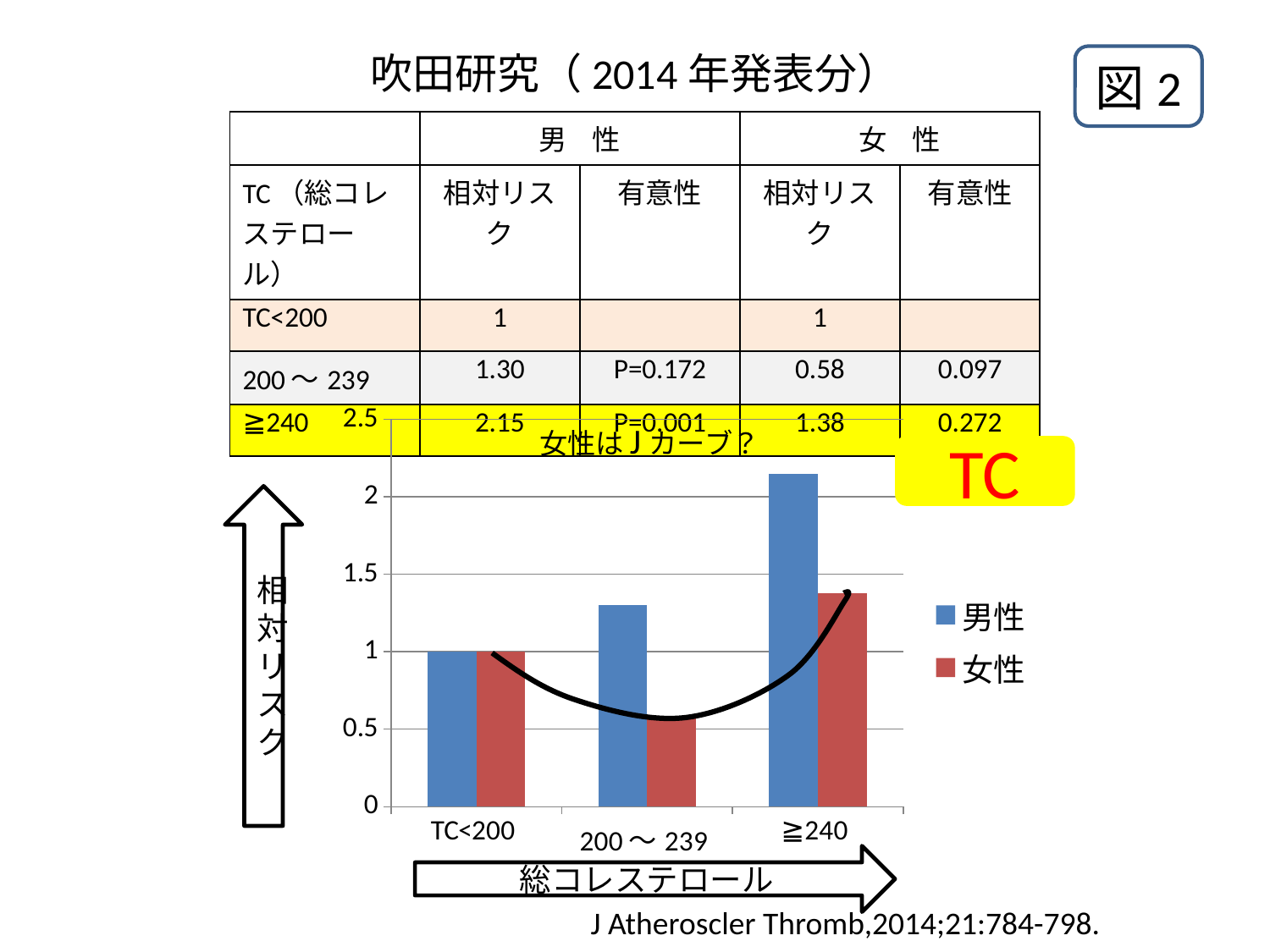
What is the relative risk value for 男性 in the ≧240 category? 2.15 How many categories are shown on the x axis of the chart? 3 Do the values for 男性 rise or fall from TC<200 to ≧240? rise Is the value for 男性 in the ≧240 category greater or less than 2? greater Which category has the lowest value for 女性? 200～239 In the ≧240 category, which series has the larger value, 男性 or 女性? 男性 How many series does the chart legend list? 2 Which category has the highest value for 男性? ≧240 What is the relative risk value for 男性 in the TC<200 category? 1 What is the difference between the 男性 and 女性 values in the ≧240 category? 0.77 What kind of chart is shown on the slide? bar chart What is the relative risk value for 女性 in the 200～239 category? 0.58